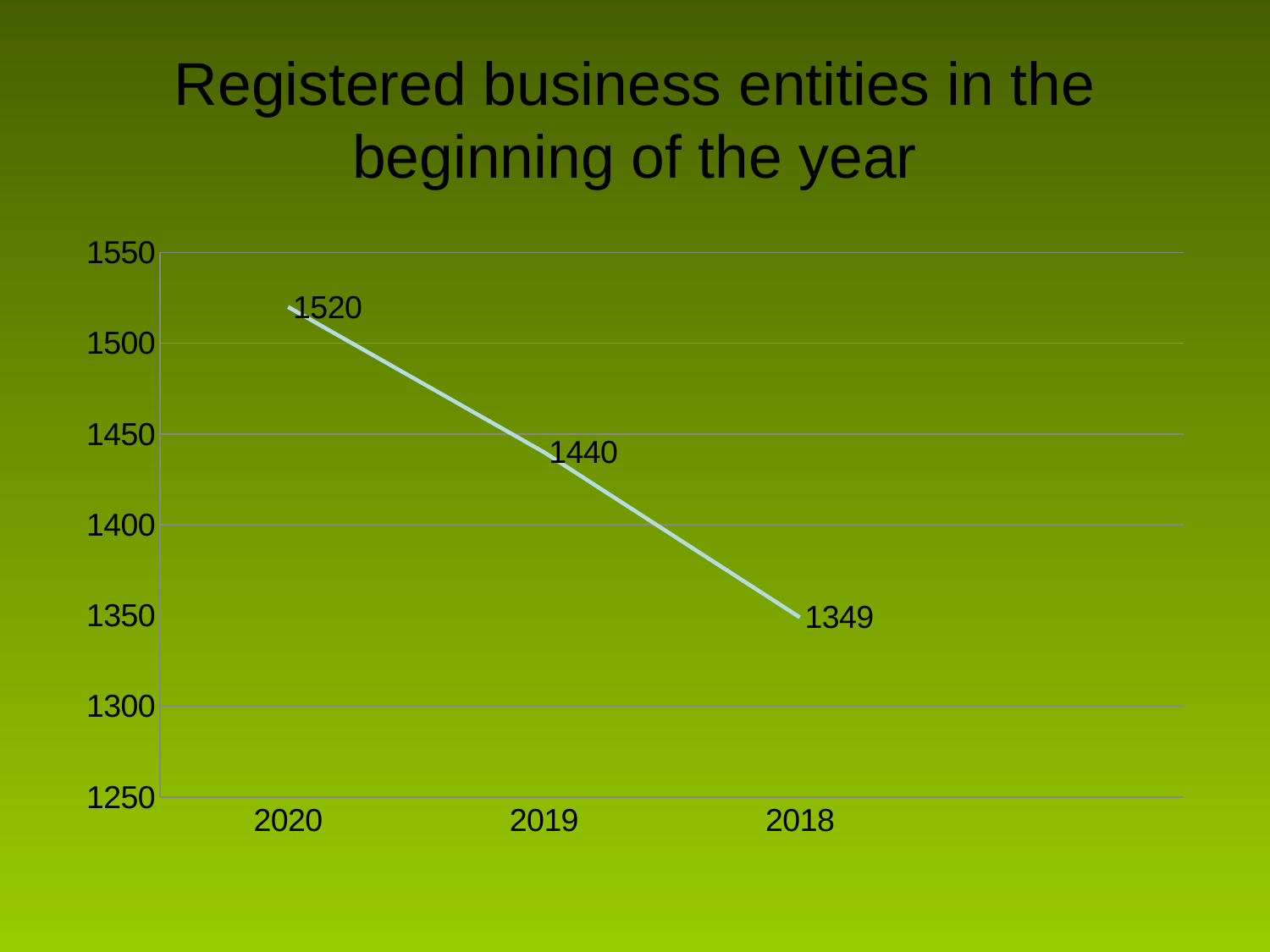
Is the value for 2018 greater or less than 1400? less What kind of chart is shown on the slide? line chart What is the value for 2019? 1440 What is the difference between the values for 2020 and 2019? 80 What is the value for 2020? 1520 What is the title of the chart? Registered business entities in the beginning of the year What is the value for 2018? 1349 What is the difference between the values for 2019 and 2018? 91 Which year has the lowest value? 2018 Which is larger, the value for 2019 or the value for 2018? 2019 How many data points are plotted on the chart? 3 Which year has the highest value? 2020